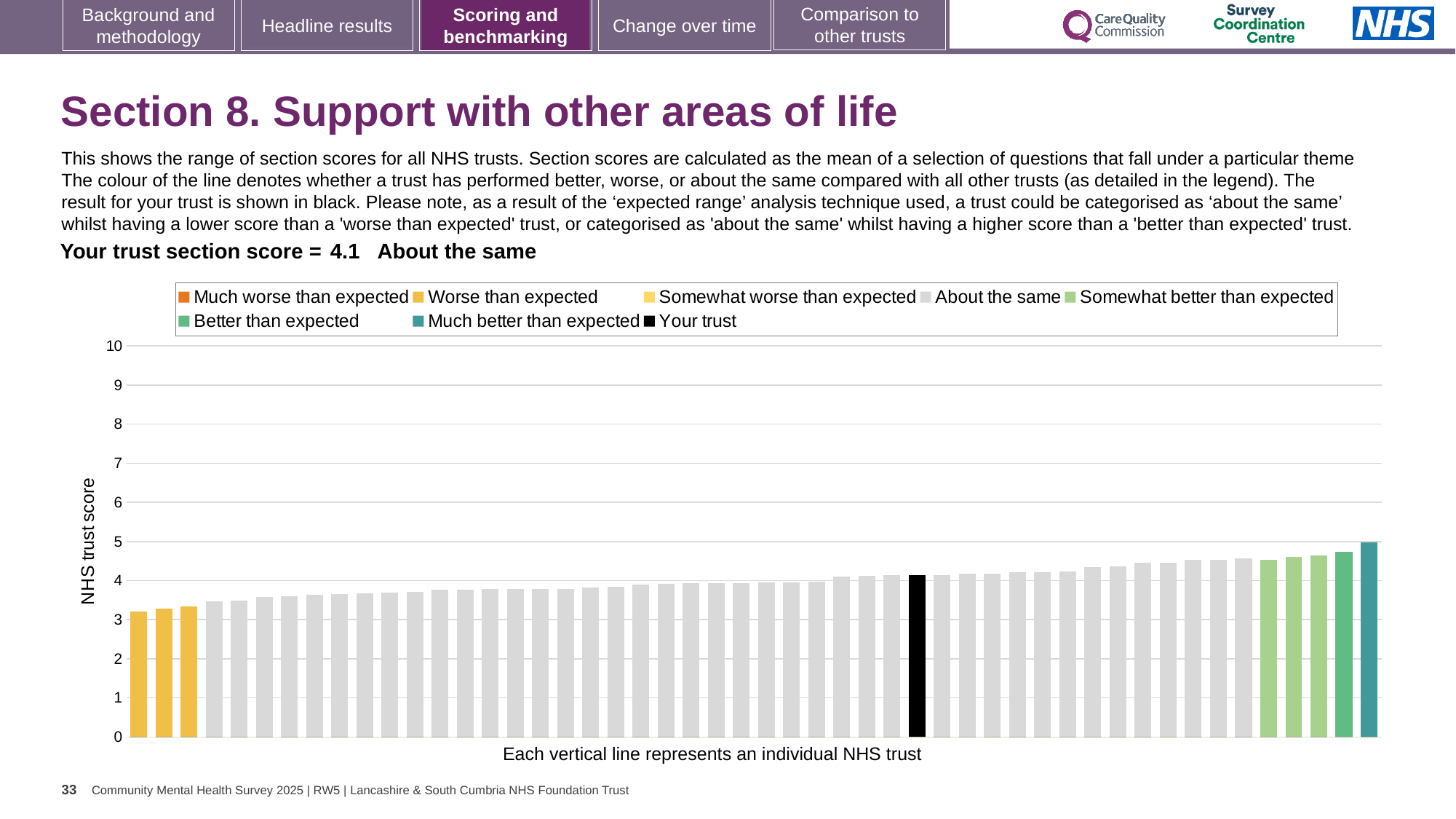
Which legend category do the shortest bars belong to? Worse than expected Do the bar values rise or fall from left to right along the x axis? rise Which legend category does the tallest bar belong to? Much better than expected Is the value of the lowest bar greater or less than 3? greater Which is larger: the value for your trust or the value of the 'Much better than expected' bar? Much better than expected How many bars are coloured as 'Worse than expected'? 3 What is the label on the vertical axis of the chart? NHS trust score Which category is your trust placed in for this section? About the same What kind of chart is shown on the slide? bar chart Is the value for your trust (the black bar) greater or less than 5? less How many entries does the chart legend list? 8 What is the section score for your trust? 4.1